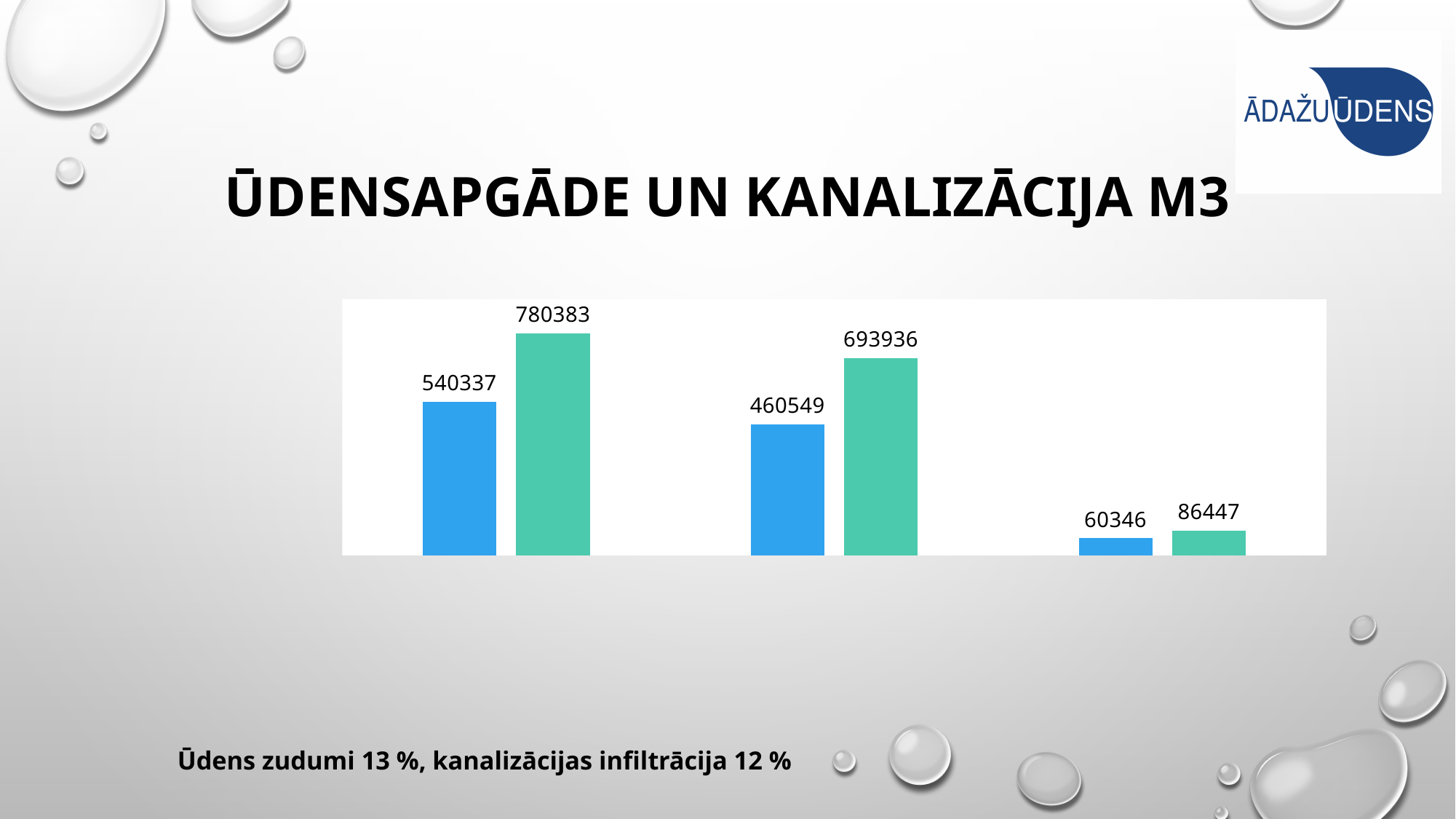
What is the value shown on the green bar in the middle group of bars? 693936 What is the value shown on the green bar in the first (leftmost) group of bars? 780383 What type of chart is shown on the slide? Bar chart What is the difference between the green and blue bars in the first (leftmost) group? 240046 In the rightmost group, which bar is larger, the blue or the green one? The green one (86447) What is the value shown on the blue bar in the first (leftmost) group of bars? 540337 Which bar has the highest value on the chart? The green bar in the first group (780383) What is the value shown on the blue bar in the rightmost group of bars? 60346 What is the value shown on the green bar in the rightmost group of bars? 86447 Which bar has the lowest value on the chart? The blue bar in the rightmost group (60346) What is the value shown on the blue bar in the middle group of bars? 460549 How many groups of bars are shown on the chart? 3